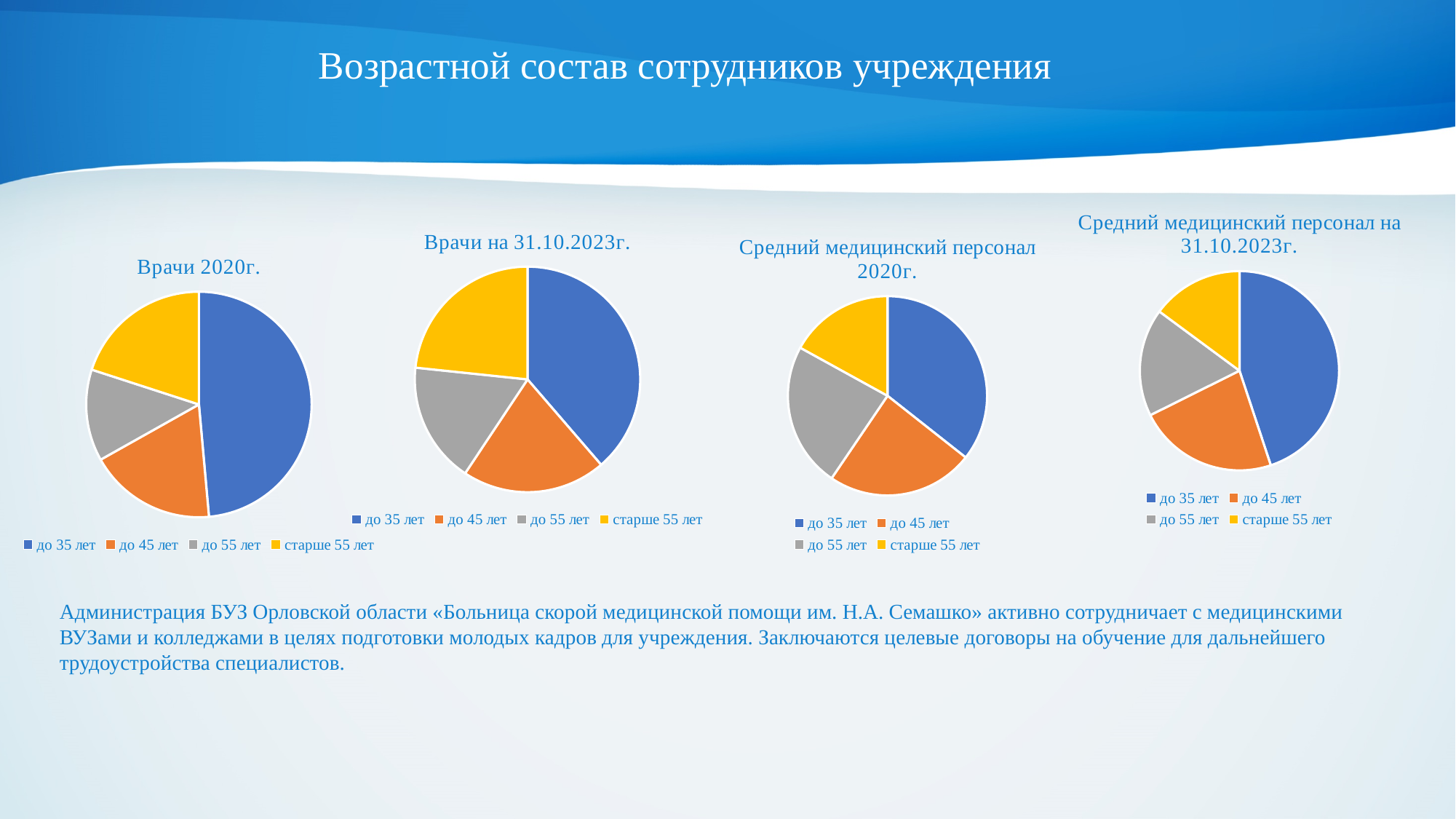
In the "Врачи на 31.10.2023г." chart, which age group has the largest slice? до 35 лет In the "Средний медицинский персонал на 31.10.2023г." chart, which age group has the largest slice? до 35 лет In the "Средний медицинский персонал на 31.10.2023г." chart, which slice is larger: "до 35 лет" or "до 45 лет"? до 35 лет How many charts are shown on the slide? 4 In the "Врачи 2020г." chart, how many slices does the pie have? 4 In the "Средний медицинский персонал 2020г." chart, which age group has the smallest slice? старше 55 лет In the "Врачи 2020г." chart, which slice is larger: "до 35 лет" or "старше 55 лет"? до 35 лет What colour represents "старше 55 лет" in the pie charts? yellow What kind of chart is "Врачи 2020г."? pie chart How many entries does the legend of the "Врачи на 31.10.2023г." chart list? 4 In the "Врачи 2020г." chart, which age group has the largest slice? до 35 лет What is the title of the chart on the far right of the slide? Средний медицинский персонал на 31.10.2023г.